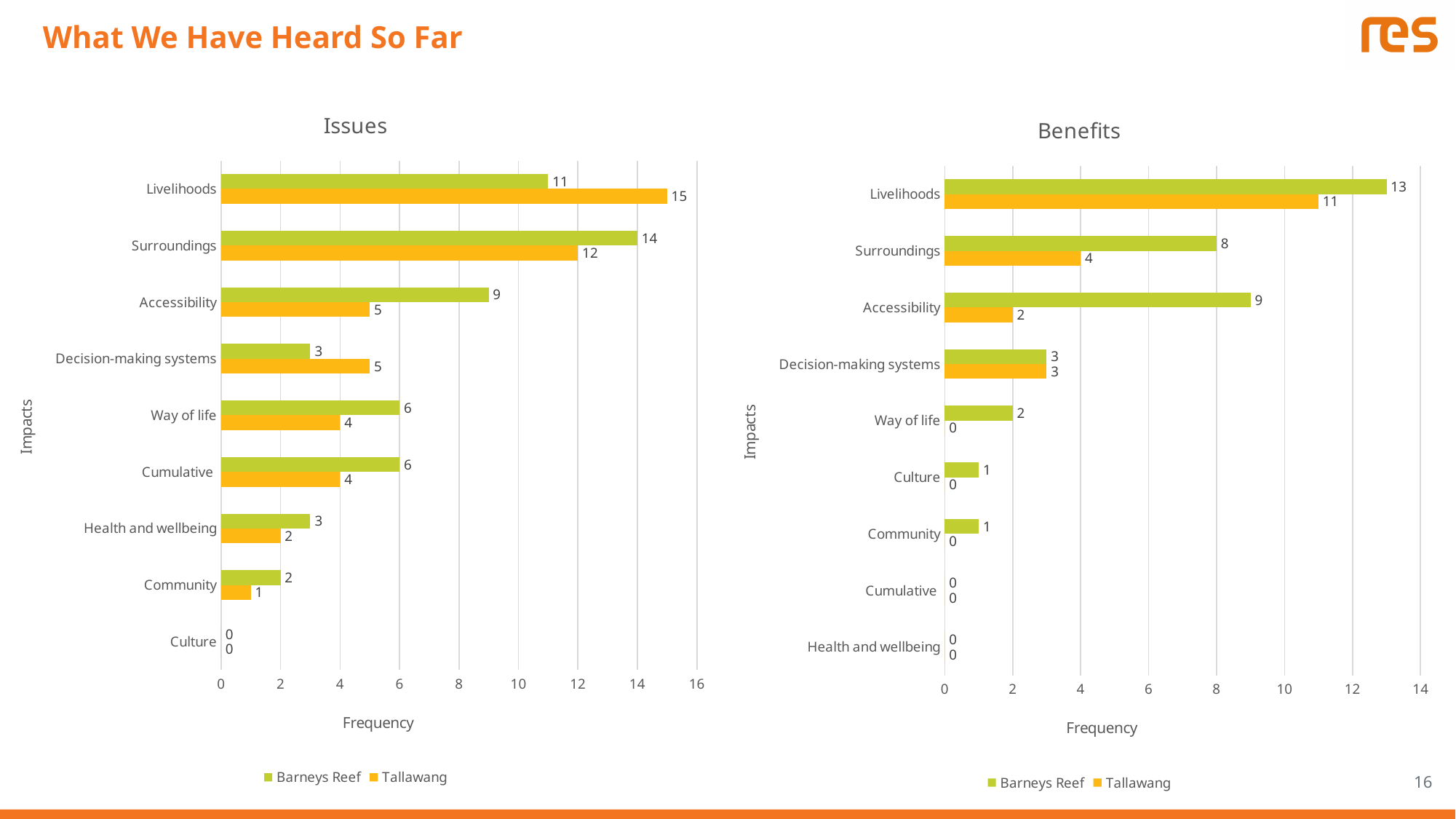
What is the label on the x axis of the Benefits chart? Frequency In the Issues chart, which is larger for Decision-making systems: Barneys Reef or Tallawang? Tallawang In the Issues chart, which category has the highest Barneys Reef value? Surroundings In the Benefits chart, what is the difference between the Barneys Reef and Tallawang values for Surroundings? 4 In the Benefits chart, which category has the highest Tallawang value? Livelihoods How many categories are shown in the Issues chart? 9 In the Benefits chart, is the Barneys Reef value for Livelihoods greater or less than 12? greater In the Issues chart, what is the difference between the Barneys Reef and Tallawang values for Accessibility? 4 In the Benefits chart, what is the Barneys Reef value for Accessibility? 9 In the Issues chart, what is the Tallawang value for Livelihoods? 15 How many series does the legend of the Benefits chart list? 2 What kind of chart is the Issues chart? Bar chart